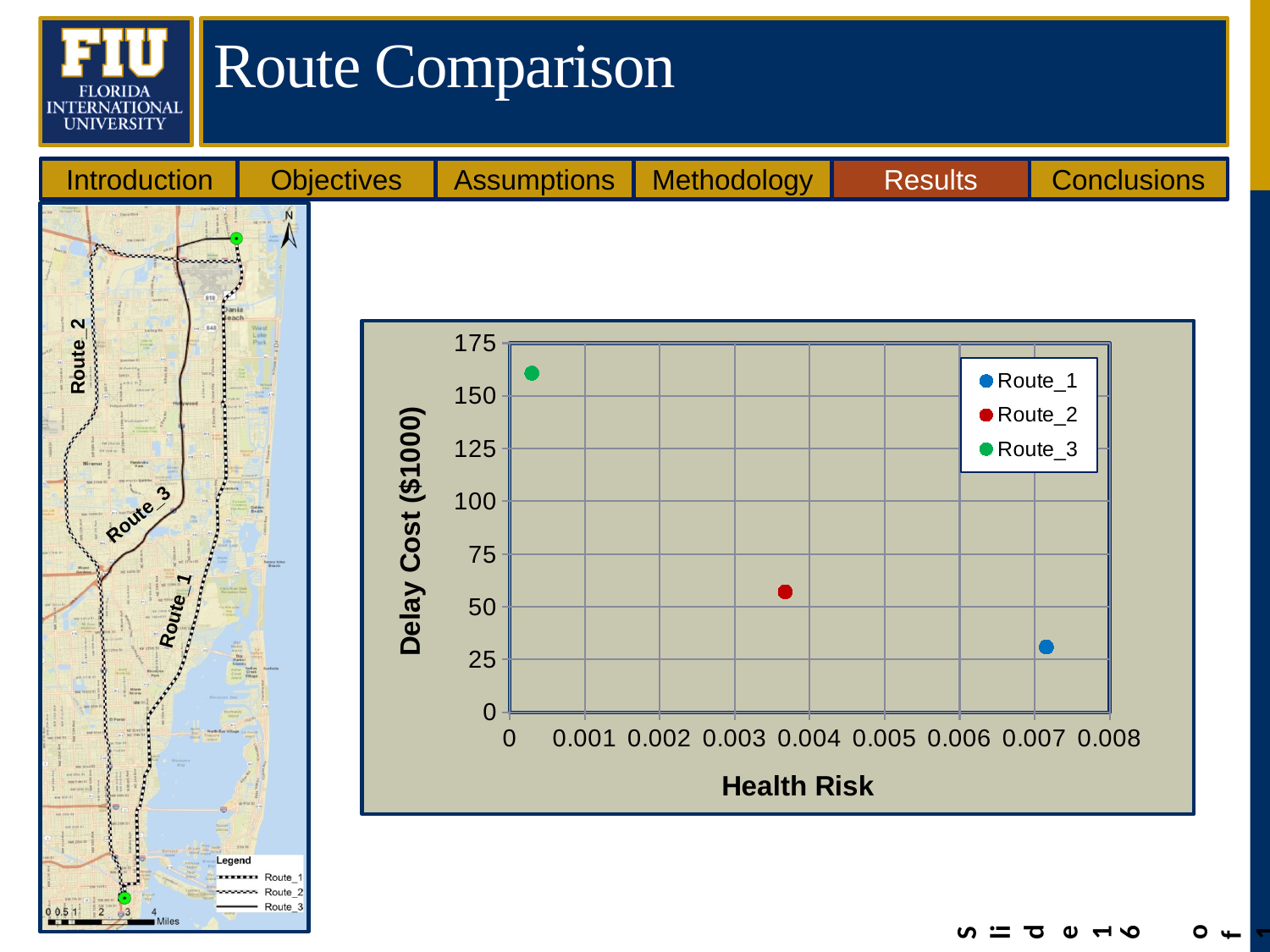
Is the delay cost for Route_1 greater or less than 50? less Which has a higher delay cost, Route_2 or Route_1? Route_2 How many series does the chart legend list? 3 Is the health risk for Route_2 greater or less than 0.003? greater Which route has the highest health risk? Route_1 What kind of chart is shown on the slide? scatter chart Which route has the lowest health risk? Route_3 Is the delay cost for Route_3 greater or less than 150? greater Which route has the highest delay cost? Route_3 Which route has the lowest delay cost? Route_1 What is the label of the vertical axis of the chart? Delay Cost ($1000) How many data points are plotted on the chart? 3